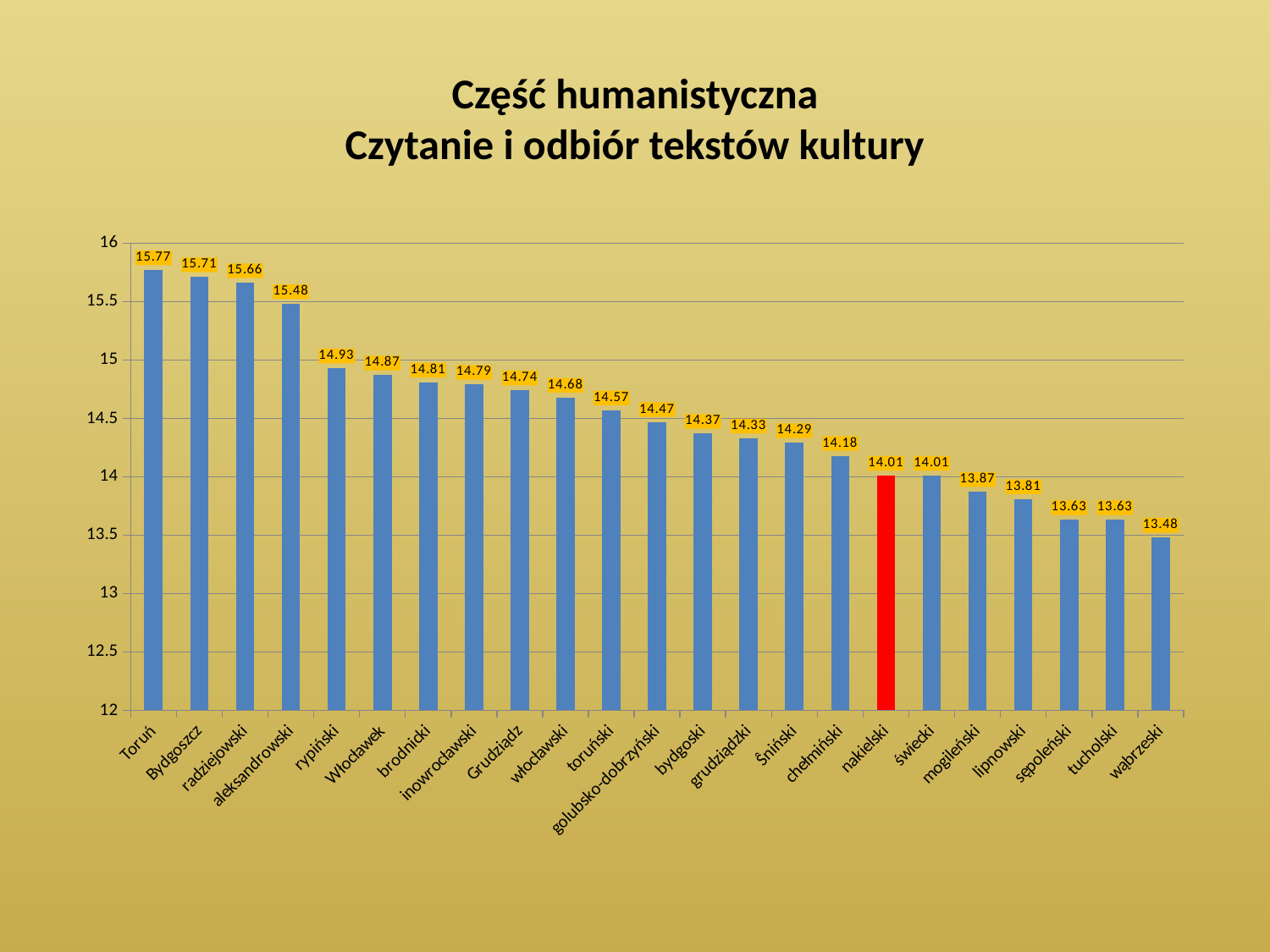
What is the value for Toruń? 15.77 Which category has the highest value? Toruń What is the value for nakielski? 14.01 What is the value for golubsko-dobrzyński? 14.47 Is the value for aleksandrowski greater or less than 15? greater What is the difference between the values for Toruń and wąbrzeski? 2.29 What kind of chart is shown on the slide? bar chart Which bar is coloured red instead of blue? nakielski What is the value for wąbrzeski? 13.48 Which category has the lowest value? wąbrzeski How many categories are shown on the x axis? 23 Which is larger, the value for Bydgoszcz or the value for Włocławek? Bydgoszcz